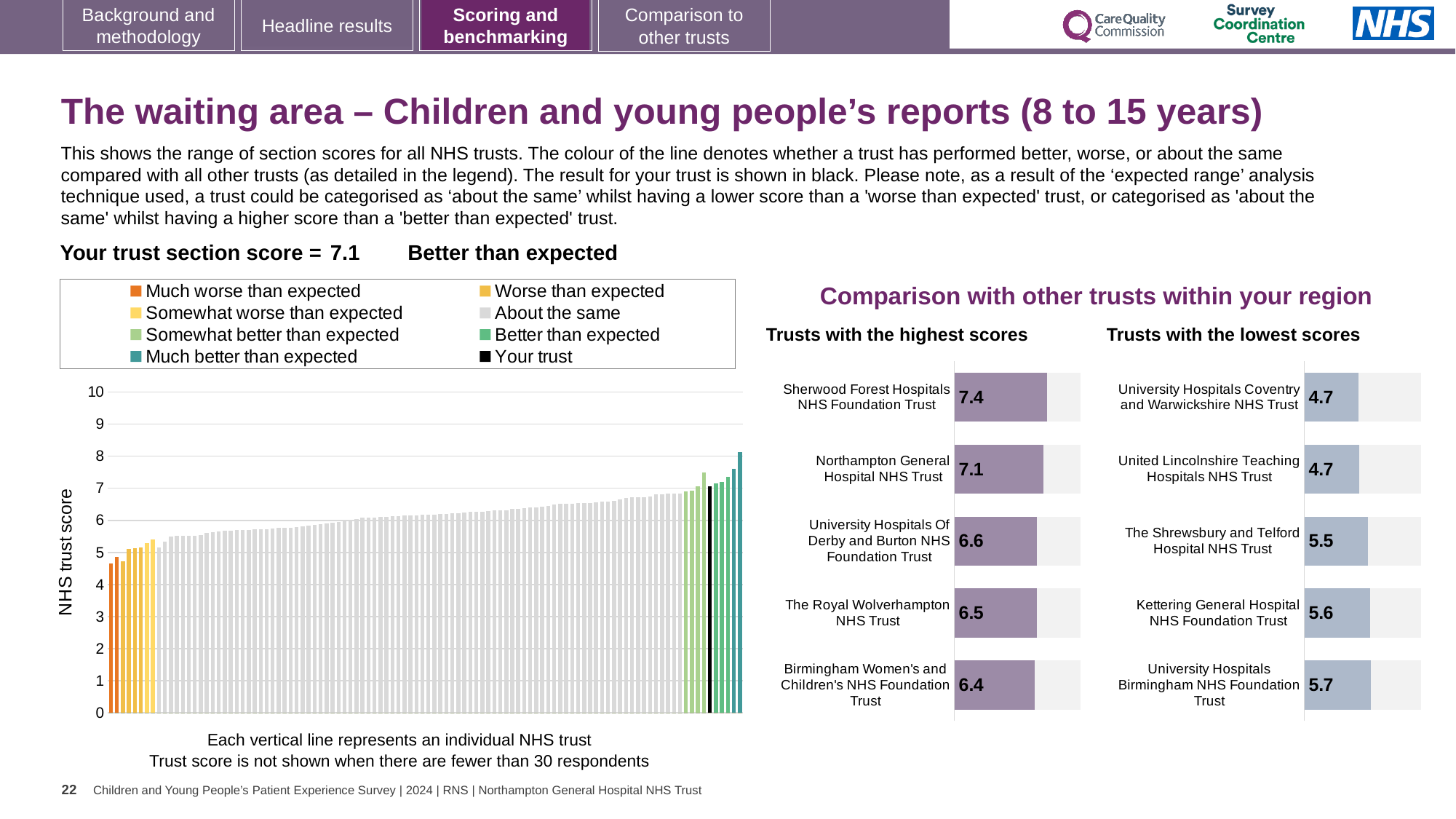
In the 'Trusts with the highest scores' chart, which trust has the highest score? Sherwood Forest Hospitals NHS Foundation Trust In the 'Trusts with the highest scores' chart, which trust has the lowest score? Birmingham Women's and Children's NHS Foundation Trust What kind of chart is the 'NHS trust score' chart on the left of the slide? Bar chart In the 'Trusts with the highest scores' chart, what is the score for Sherwood Forest Hospitals NHS Foundation Trust? 7.4 In the 'Trusts with the lowest scores' chart, what is the score for The Shrewsbury and Telford Hospital NHS Trust? 5.5 In the 'Trusts with the lowest scores' chart, which is larger: the score for Kettering General Hospital NHS Foundation Trust or United Lincolnshire Teaching Hospitals NHS Trust? Kettering General Hospital NHS Foundation Trust How many entries does the legend of the 'NHS trust score' chart on the left list? 8 In the 'Trusts with the highest scores' chart, what is the score for Northampton General Hospital NHS Trust? 7.1 In the 'Trusts with the lowest scores' chart, which trust has the highest score? University Hospitals Birmingham NHS Foundation Trust In the 'Trusts with the highest scores' chart, what is the difference between the scores of Sherwood Forest Hospitals NHS Foundation Trust and Birmingham Women's and Children's NHS Foundation Trust? 1.0 In the 'NHS trust score' chart on the left, do the bar values rise or fall from left to right? Rise How many trusts are shown in the 'Trusts with the lowest scores' chart? 5